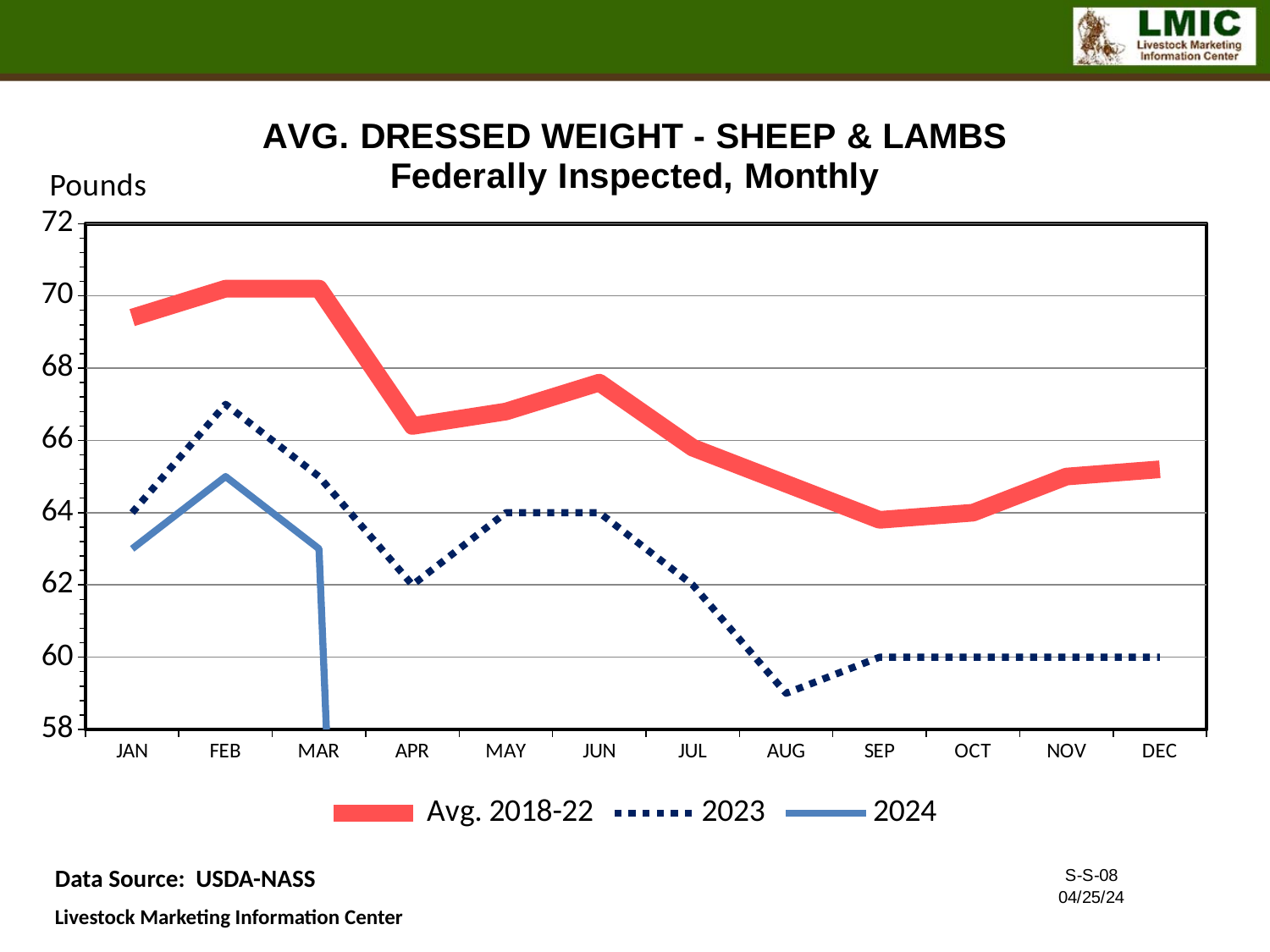
What kind of chart is shown on the slide? Line chart Is the Avg. 2018-22 value for JAN greater or less than 68? greater In FEB, which series is higher: 2023 or 2024? 2023 How many series does the legend list? 3 What is the 2023 value for APR? 62 Does the Avg. 2018-22 series rise or fall from MAR to SEP? Fall How many months are shown along the x axis? 12 In which month is the 2023 series highest? FEB What is the 2023 value for SEP? 60 Is the 2024 value for JAN greater or less than 64? less What is the 2023 value for JUN? 64 In which month is the 2023 series lowest? AUG